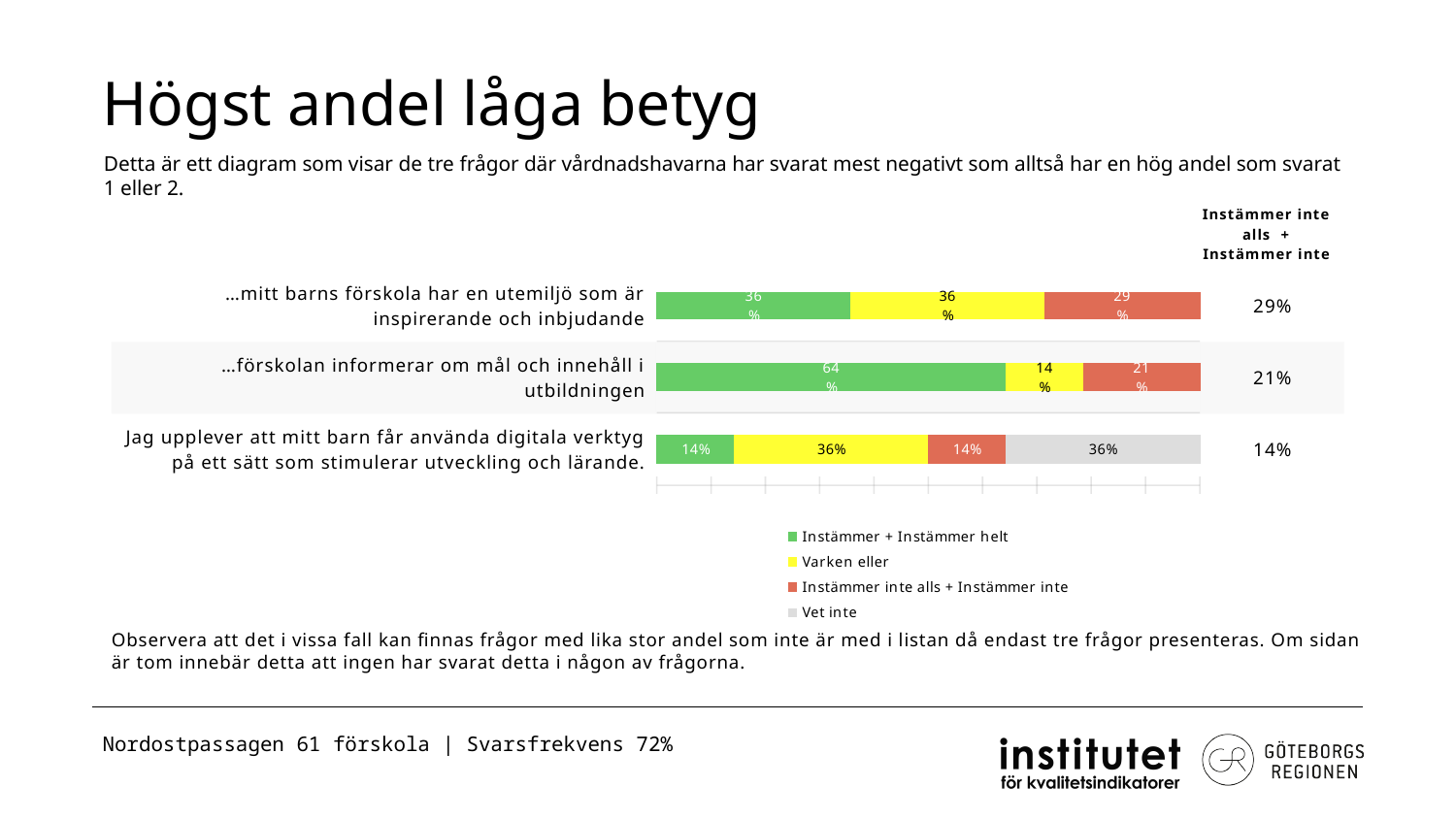
Which is larger: the 'Instämmer + Instämmer helt' value for '…förskolan informerar om mål och innehåll i utbildningen' or for '…mitt barns förskola har en utemiljö som är inspirerande och inbjudande'? …förskolan informerar om mål och innehåll i utbildningen Which category has the highest 'Instämmer inte alls + Instämmer inte' share? …mitt barns förskola har en utemiljö som är inspirerande och inbjudande What is the difference between the 'Instämmer inte alls + Instämmer inte' values for '…mitt barns förskola har en utemiljö som är inspirerande och inbjudande' and '…förskolan informerar om mål och innehåll i utbildningen'? 8 percentage points What kind of chart is shown on the slide? Stacked bar chart Which colour represents 'Vet inte' in the chart? Grey What is the 'Instämmer inte alls + Instämmer inte' value for '…mitt barns förskola har en utemiljö som är inspirerande och inbjudande'? 29% What is the 'Instämmer + Instämmer helt' value for '…förskolan informerar om mål och innehåll i utbildningen'? 64% How many series does the legend list? 4 Which category has the lowest 'Instämmer inte alls + Instämmer inte' share? Jag upplever att mitt barn får använda digitala verktyg på ett sätt som stimulerar utveckling och lärande What is the 'Vet inte' value for 'Jag upplever att mitt barn får använda digitala verktyg på ett sätt som stimulerar utveckling och lärande'? 36% How many categories (questions) are plotted in the chart? 3 What is the 'Varken eller' value for '…förskolan informerar om mål och innehåll i utbildningen'? 14%